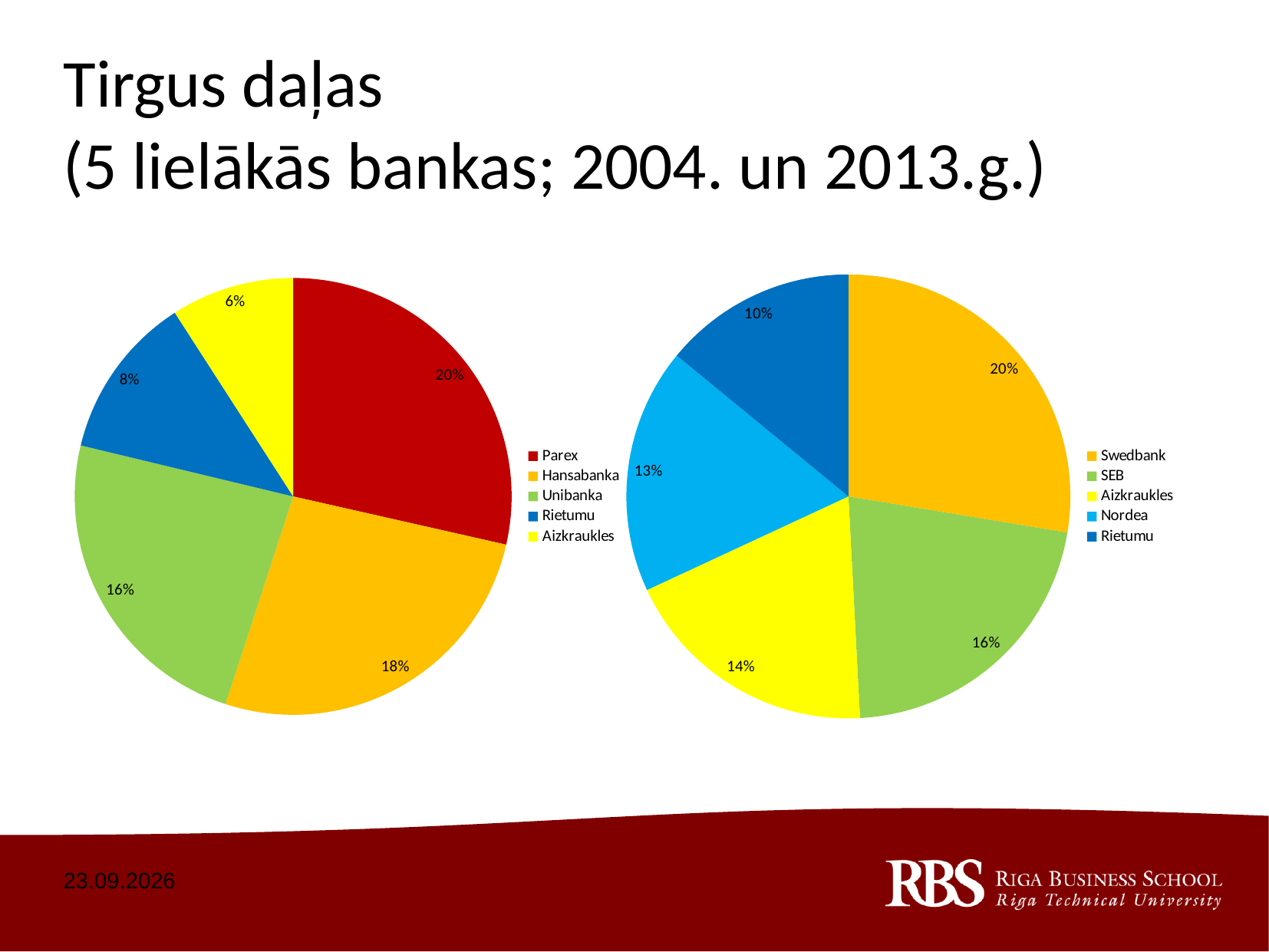
What type of chart is shown on the left of the slide? Pie chart How many slices does the right pie chart have? 5 In the left pie chart, which bank has the smallest share? Aizkraukles In the right pie chart, what share does Nordea have? 13% In the left pie chart, which bank has the largest share? Parex In the right pie chart, which bank has the largest share? Swedbank In the right pie chart, what share does SEB have? 16% In the right pie chart, which is larger, the share of Aizkraukles or the share of Rietumu? Aizkraukles In the left pie chart, what is the difference between the shares of Unibanka and Aizkraukles? 10% In the left pie chart, what share does Parex have? 20% In the left pie chart, what share does Hansabanka have? 18% In the left pie chart, what share does Rietumu have? 8%